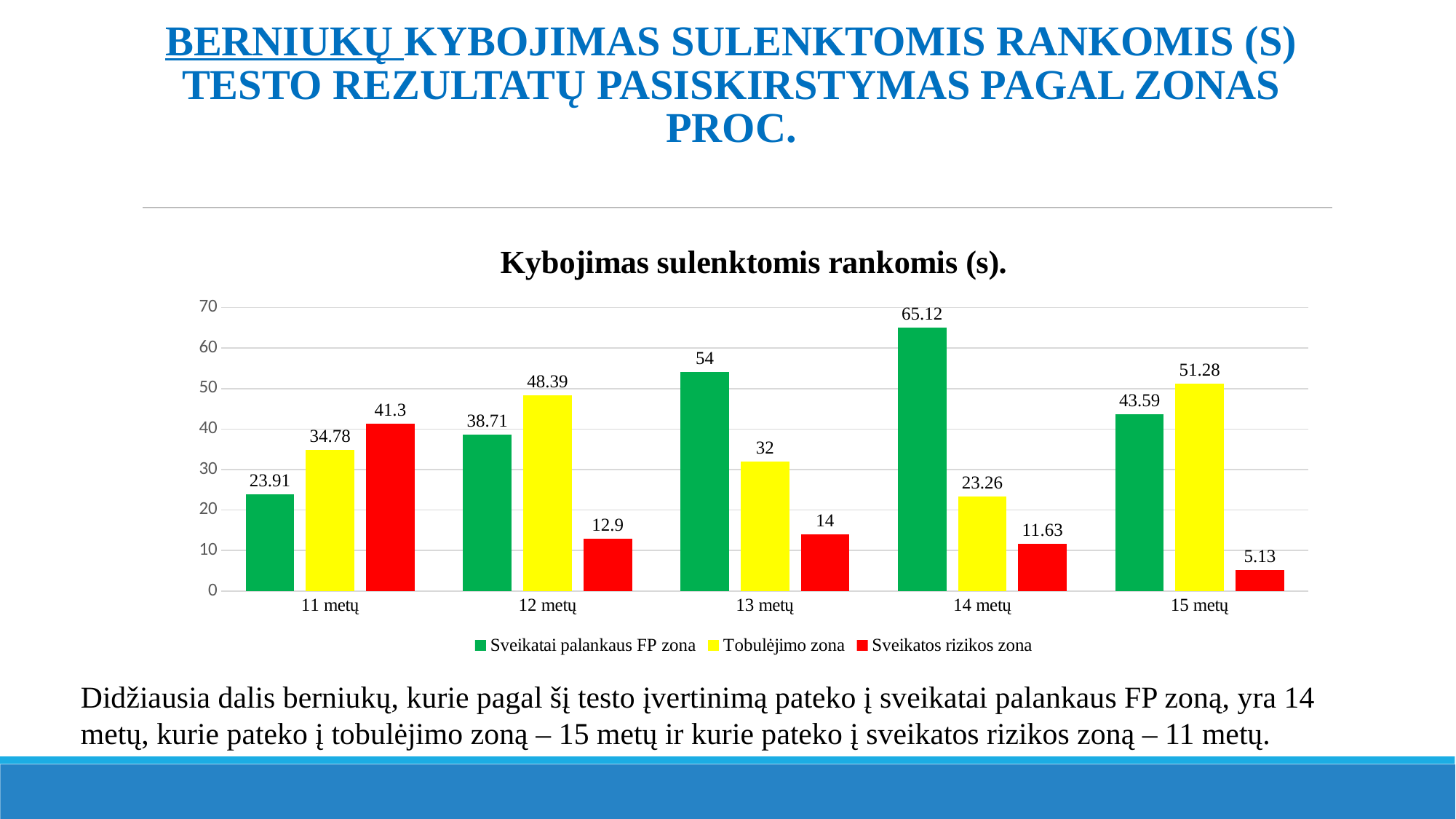
Which age group has the highest value for Sveikatai palankaus FP zona? 14 metų What is the difference between the Tobulėjimo zona values at 15 metų and 14 metų? 28.02 Does the Sveikatos rizikos zona value rise or fall from 11 metų to 12 metų? Fall What colour represents Tobulėjimo zona in the chart? Yellow How many series does the legend list? 3 Which age group has the lowest value for Sveikatos rizikos zona? 15 metų At 11 metų, which is larger: Sveikatai palankaus FP zona or Sveikatos rizikos zona? Sveikatos rizikos zona What is the value for Sveikatos rizikos zona at 15 metų? 5.13 What is the value for Sveikatai palankaus FP zona at 14 metų? 65.12 What kind of chart is shown on the slide? Bar chart What is the value for Tobulėjimo zona at 12 metų? 48.39 How many age groups are shown on the x axis? 5